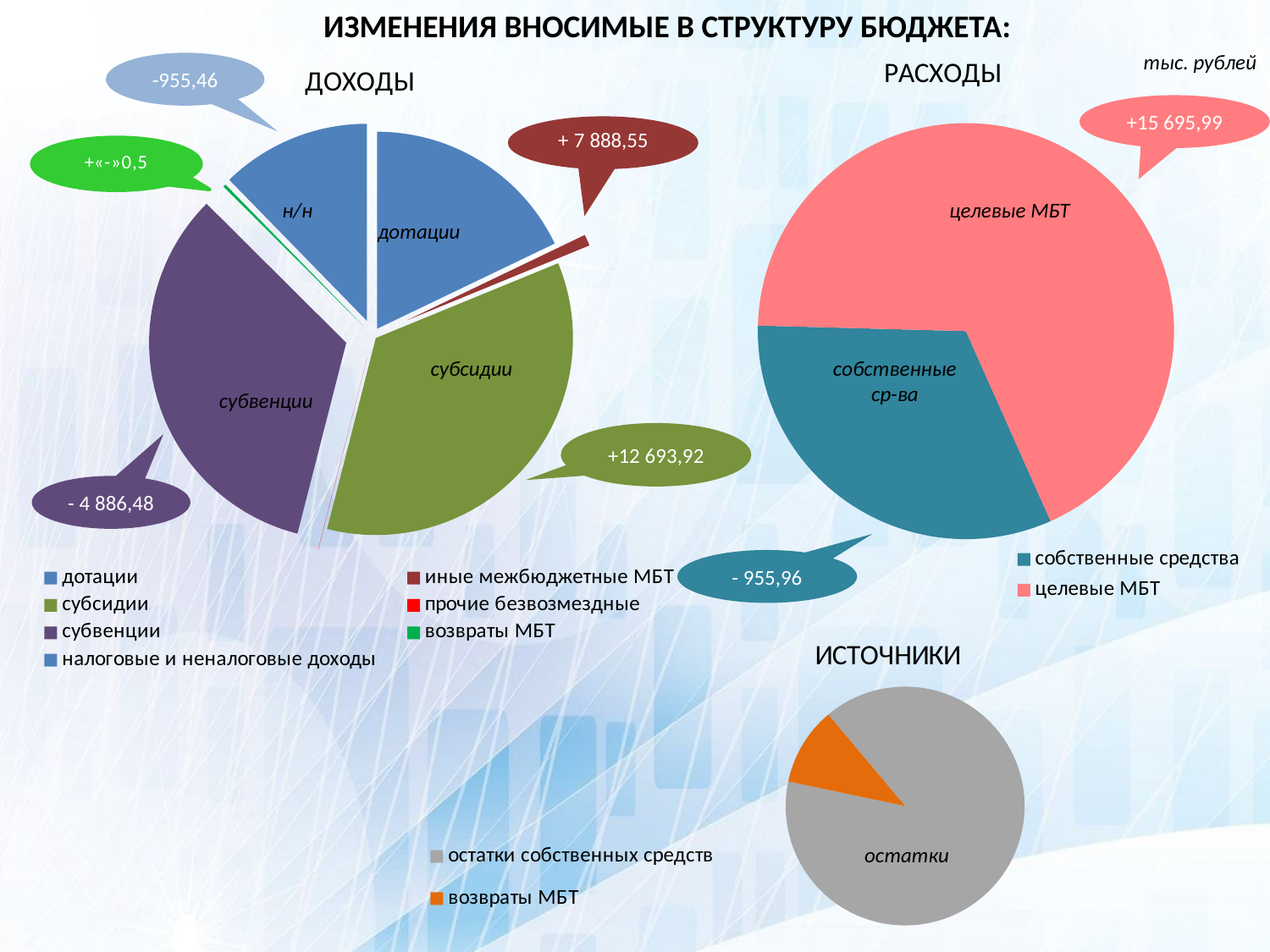
In the РАСХОДЫ chart, what change is shown in the callout for целевые МБТ? +15 695,99 In the ДОХОДЫ chart, what change is shown in the callout for субсидии? +12 693,92 In the ДОХОДЫ chart, what change is shown in the callout for субвенции? - 4 886,48 What unit is stated for the values on the slide? тыс. рублей How many entries does the legend of the ДОХОДЫ chart list? 7 In the ИСТОЧНИКИ chart, which slice is the smallest? возвраты МБТ In the РАСХОДЫ chart, what change is shown in the callout for собственные средства? - 955,96 How many entries does the legend of the РАСХОДЫ chart list? 2 What kind of chart is the ДОХОДЫ chart? pie chart In the ДОХОДЫ chart, which slice is larger: дотации or субсидии? субсидии In the РАСХОДЫ chart, which slice is the largest? целевые МБТ In the ИСТОЧНИКИ chart, which slice is the largest? остатки собственных средств